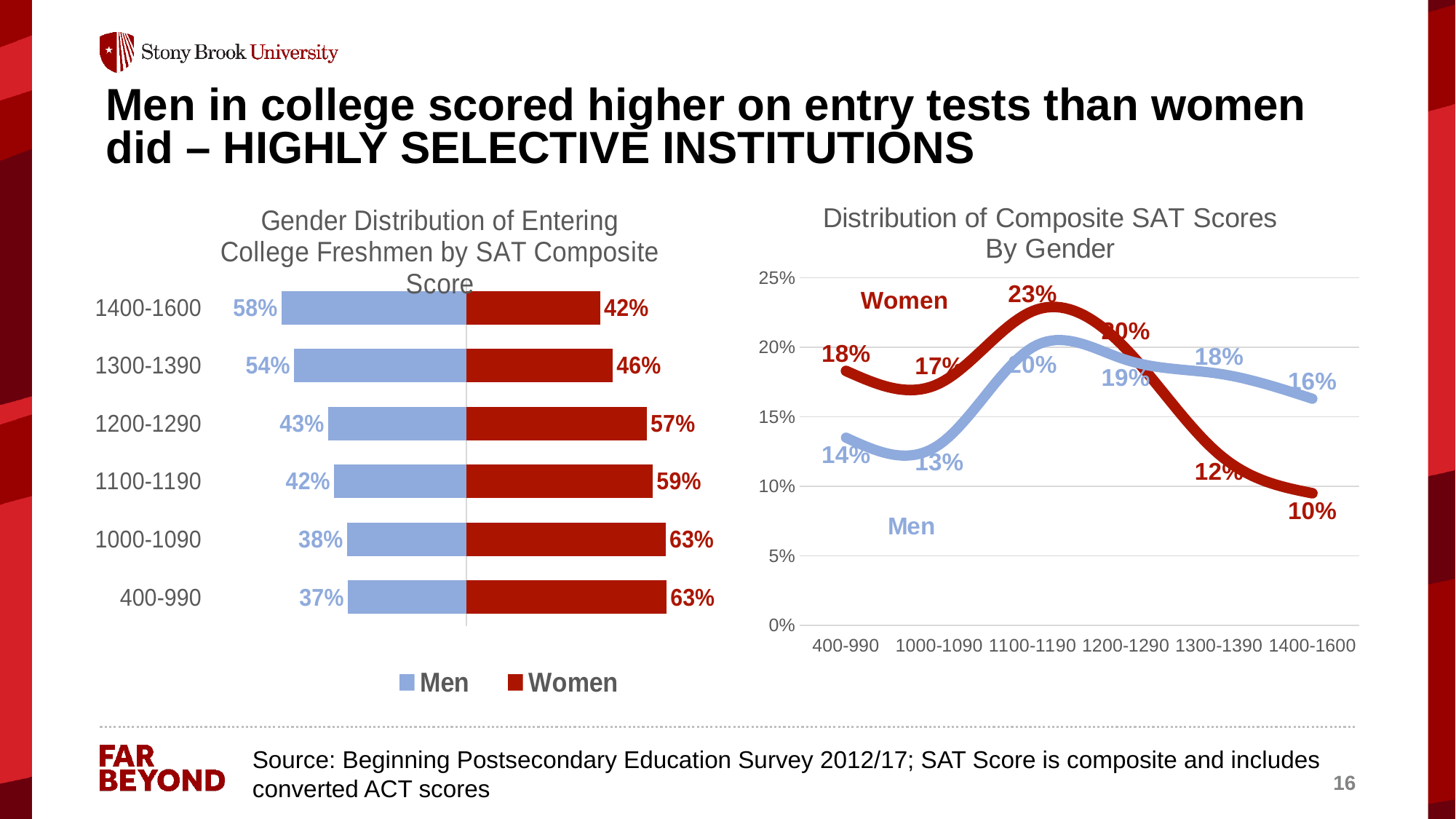
In the right chart, Distribution of Composite SAT Scores By Gender, what is the value for Women in the 1100-1190 band? 23% What kind of chart is the left chart, Gender Distribution of Entering College Freshmen by SAT Composite Score? Bar chart In the left chart, Gender Distribution of Entering College Freshmen by SAT Composite Score, what is the value for Men in the 1400-1600 score band? 58% In the right chart, Distribution of Composite SAT Scores By Gender, which is larger in the 1400-1600 band, the Men value or the Women value? Men In the left chart, Gender Distribution of Entering College Freshmen by SAT Composite Score, which score band has the highest value for Men? 1400-1600 In the left chart, Gender Distribution of Entering College Freshmen by SAT Composite Score, how many series does the legend list? 2 What kind of chart is the right chart, Distribution of Composite SAT Scores By Gender? Line chart In the right chart, Distribution of Composite SAT Scores By Gender, what is the value for Men in the 1400-1600 band? 16% In the left chart, Gender Distribution of Entering College Freshmen by SAT Composite Score, what is the value for Women in the 1200-1290 score band? 57% In the left chart, Gender Distribution of Entering College Freshmen by SAT Composite Score, how many score bands are shown? 6 In the left chart, Gender Distribution of Entering College Freshmen by SAT Composite Score, what is the difference between the Women and Men values in the 1000-1090 band? 25% In the left chart, Gender Distribution of Entering College Freshmen by SAT Composite Score, which score band has the lowest value for Women? 1400-1600